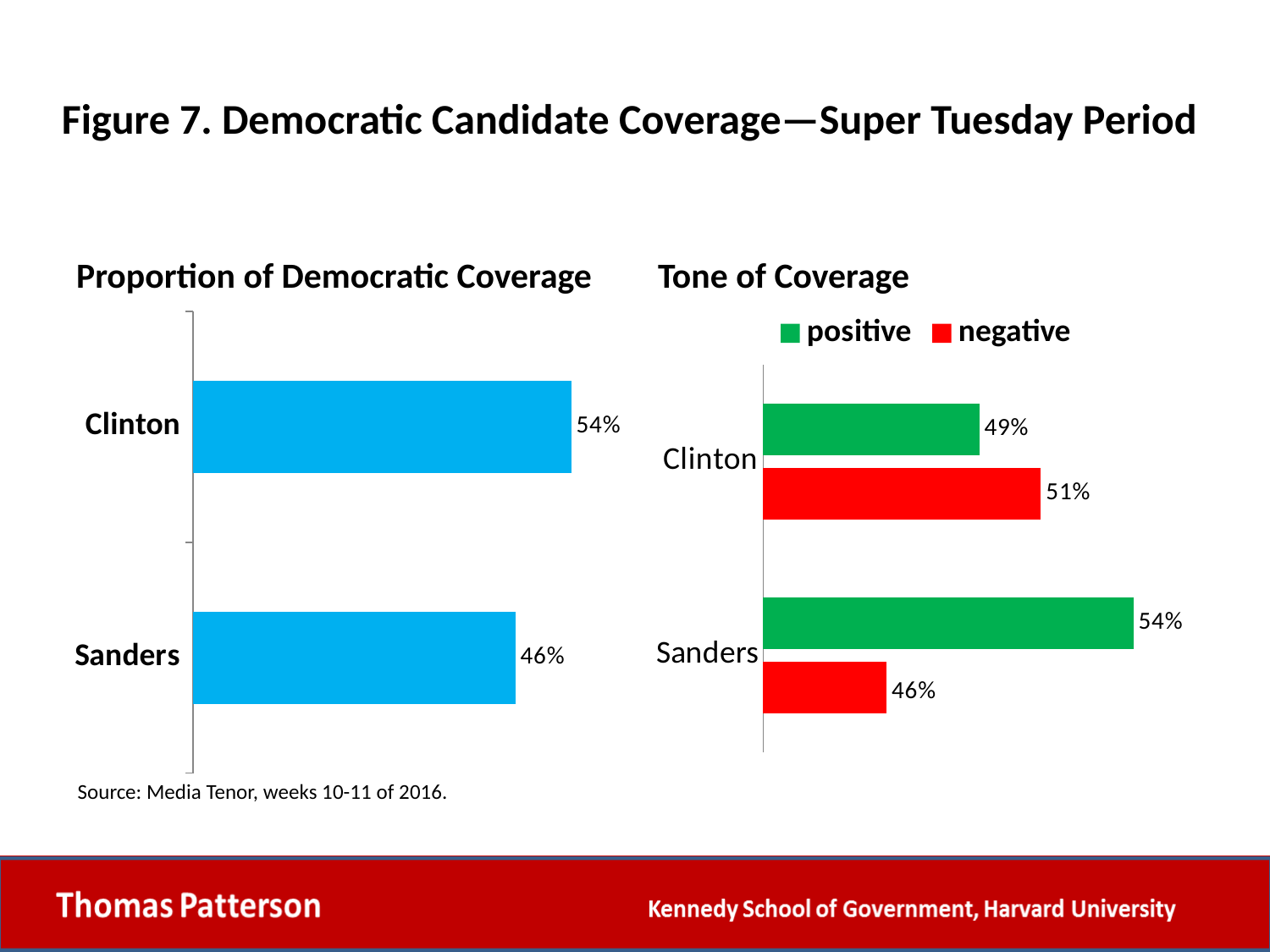
In the 'Tone of Coverage' chart, what is the positive value for Clinton? 49% How many series does the legend of the 'Tone of Coverage' chart list? 2 In the 'Tone of Coverage' chart, which candidate has the higher positive value? Sanders What kind of chart is the 'Tone of Coverage' chart? Bar chart In the 'Proportion of Democratic Coverage' chart, what is the difference between Clinton's and Sanders' values? 8% In the 'Proportion of Democratic Coverage' chart, what is the value for Clinton? 54% In the 'Tone of Coverage' chart, what is the negative value for Sanders? 46% In the 'Proportion of Democratic Coverage' chart, what is the value for Sanders? 46% How many candidates are shown in the 'Proportion of Democratic Coverage' chart? 2 In the 'Tone of Coverage' chart, what is the difference between Sanders' positive and negative values? 8% In the 'Proportion of Democratic Coverage' chart, which candidate has the higher proportion of coverage? Clinton In the 'Tone of Coverage' chart, what is the negative value for Clinton? 51%